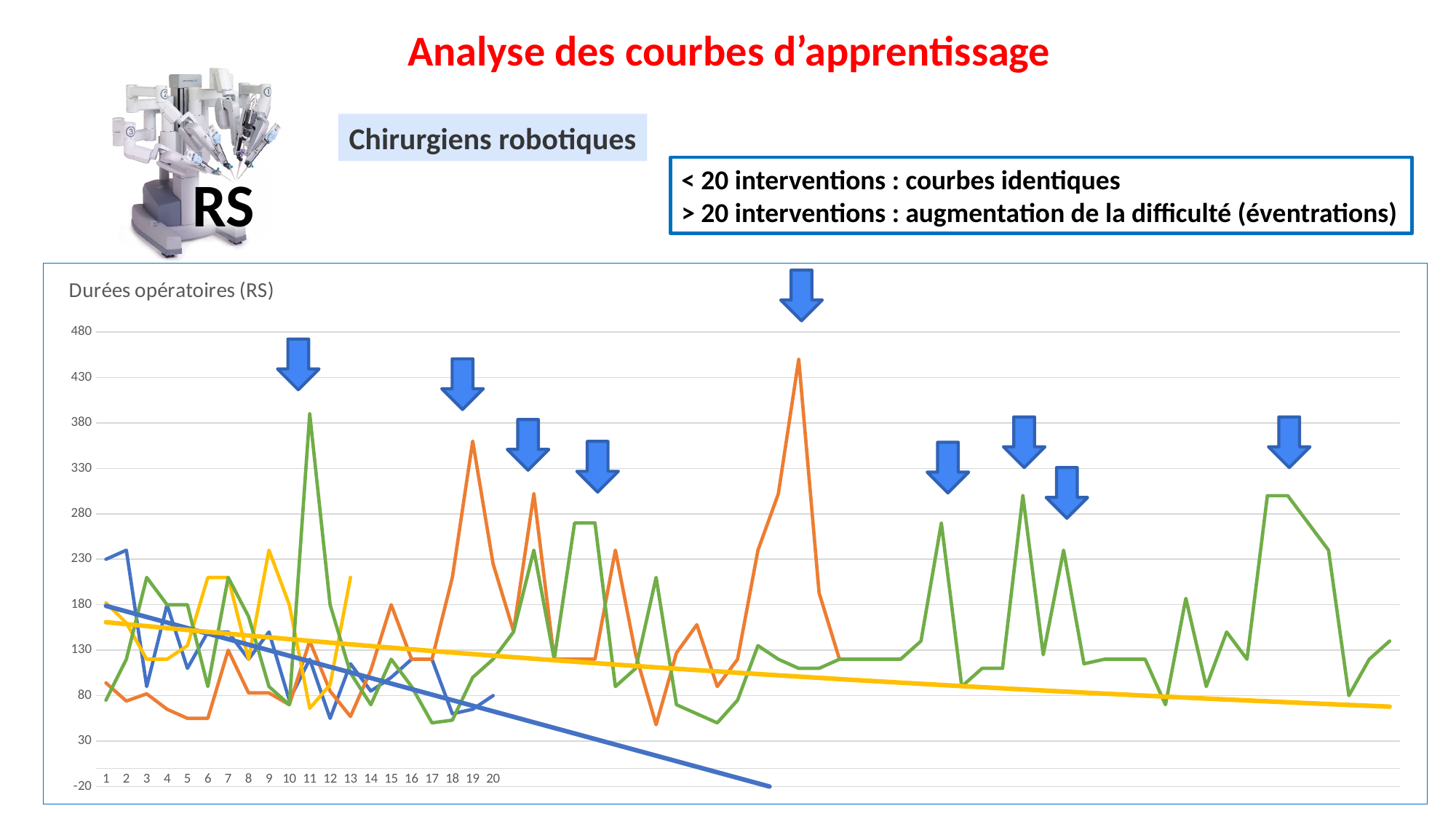
Which line reaches a higher peak, the orange line or the green line? orange How many numbered labels are shown on the horizontal axis? 20 Is the first point of the blue line (at 1) greater or less than 180? greater Is the highest point of the orange line greater or less than 430? greater What is the highest value shown on the vertical axis? 480 Is the right-hand end of the blue straight trend line greater or less than 30? less What kind of chart is shown on the slide? line chart Does the yellow straight trend line rise or fall from left to right? fall What is the title of the chart? Durées opératoires (RS) Does the blue straight trend line rise or fall from left to right? fall